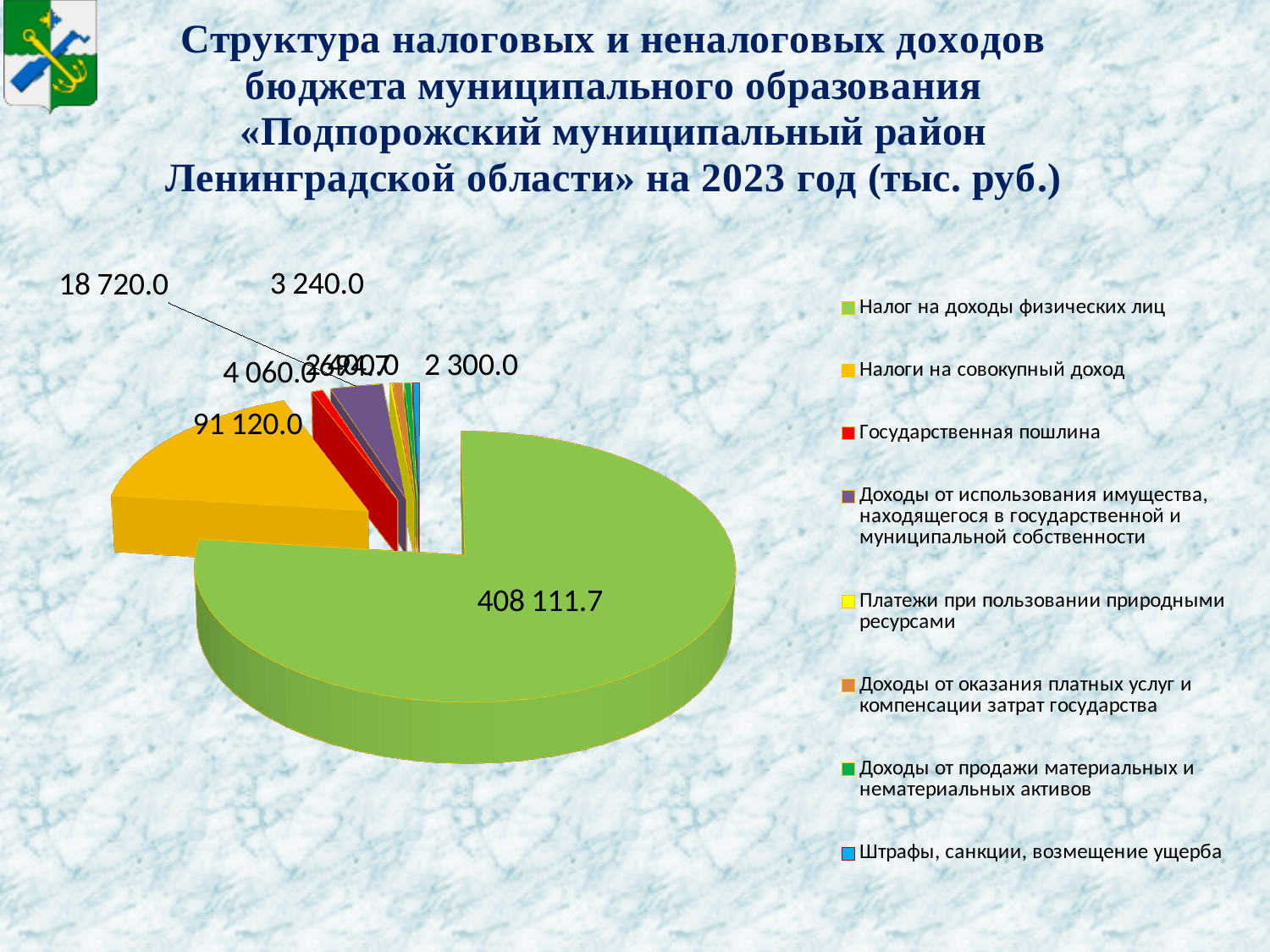
What is the value for Государственная пошлина? 4 060.0 Which is larger: Налоги на совокупный доход or Государственная пошлина? Налоги на совокупный доход What is the value for Налоги на совокупный доход? 91 120.0 What is the value for Доходы от использования имущества, находящегося в государственной и муниципальной собственности? 18 720.0 What is the difference between Налог на доходы физических лиц and Налоги на совокупный доход? 316 991.7 What colour is the slice for Налог на доходы физических лиц? Green Which legend entry is shown in red? Государственная пошлина Which category has the largest slice of the pie? Налог на доходы физических лиц What is the value for Налог на доходы физических лиц? 408 111.7 What is the difference between Налоги на совокупный доход and Доходы от использования имущества, находящегося в государственной и муниципальной собственности? 72 400.0 What type of chart is shown on the slide? Pie chart How many categories does the legend list? 8